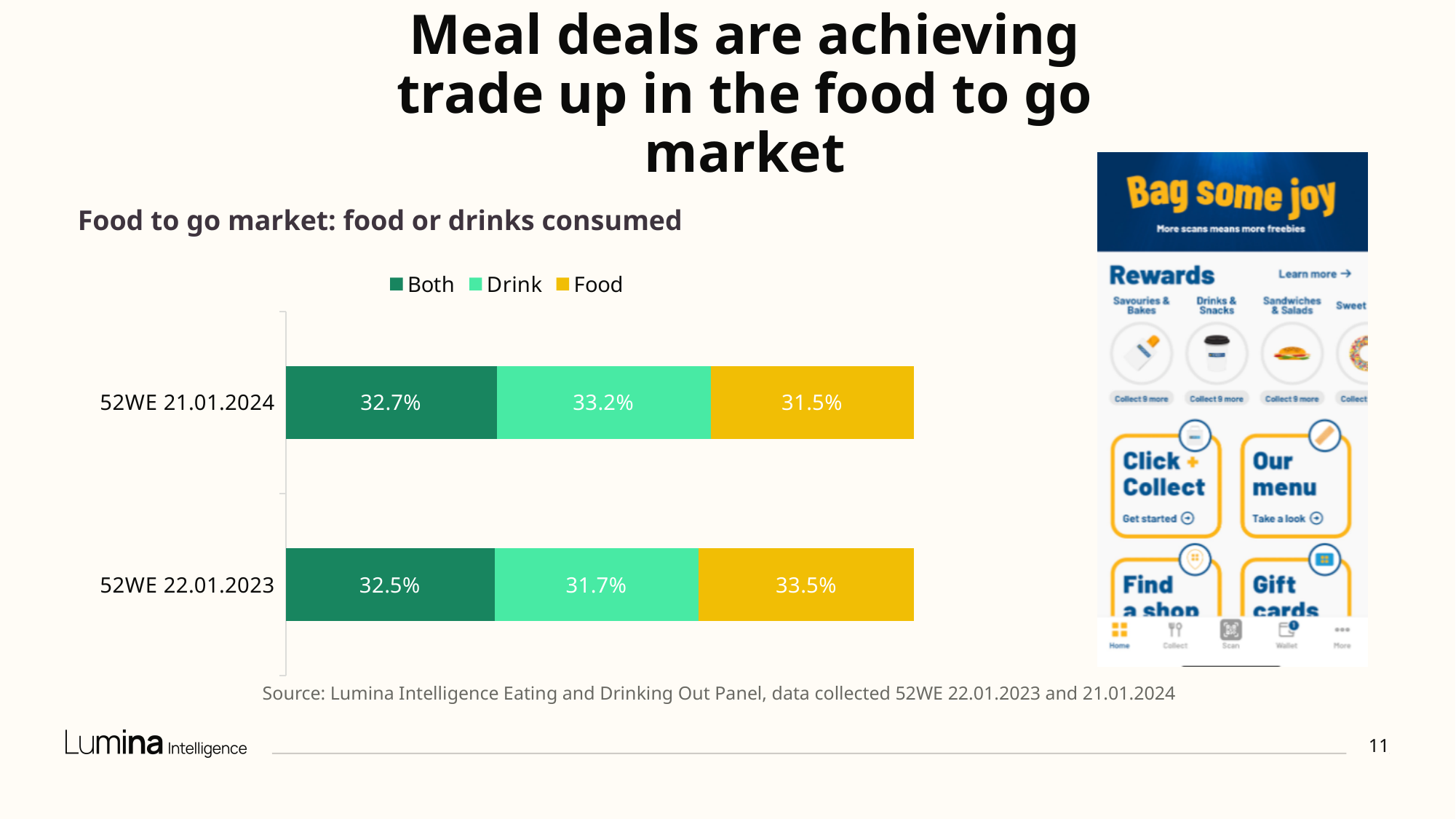
How many series does the legend list? 3 Which series has the lowest value in 52WE 21.01.2024? Food Which series has the highest value in 52WE 22.01.2023? Food What is the value for Drink in 52WE 22.01.2023? 31.7% What is the difference between the Drink values for 52WE 21.01.2024 and 52WE 22.01.2023? 1.5% What is the value for Food in 52WE 22.01.2023? 33.5% How many categories (time periods) are shown on the chart? 2 What is the value for Both in 52WE 21.01.2024? 32.7% Which is larger, the Food value in 52WE 22.01.2023 or the Food value in 52WE 21.01.2024? 52WE 22.01.2023 What kind of chart is shown on the slide? Stacked bar chart What is the value for Food in 52WE 21.01.2024? 31.5% What is the title of the chart? Food to go market: food or drinks consumed